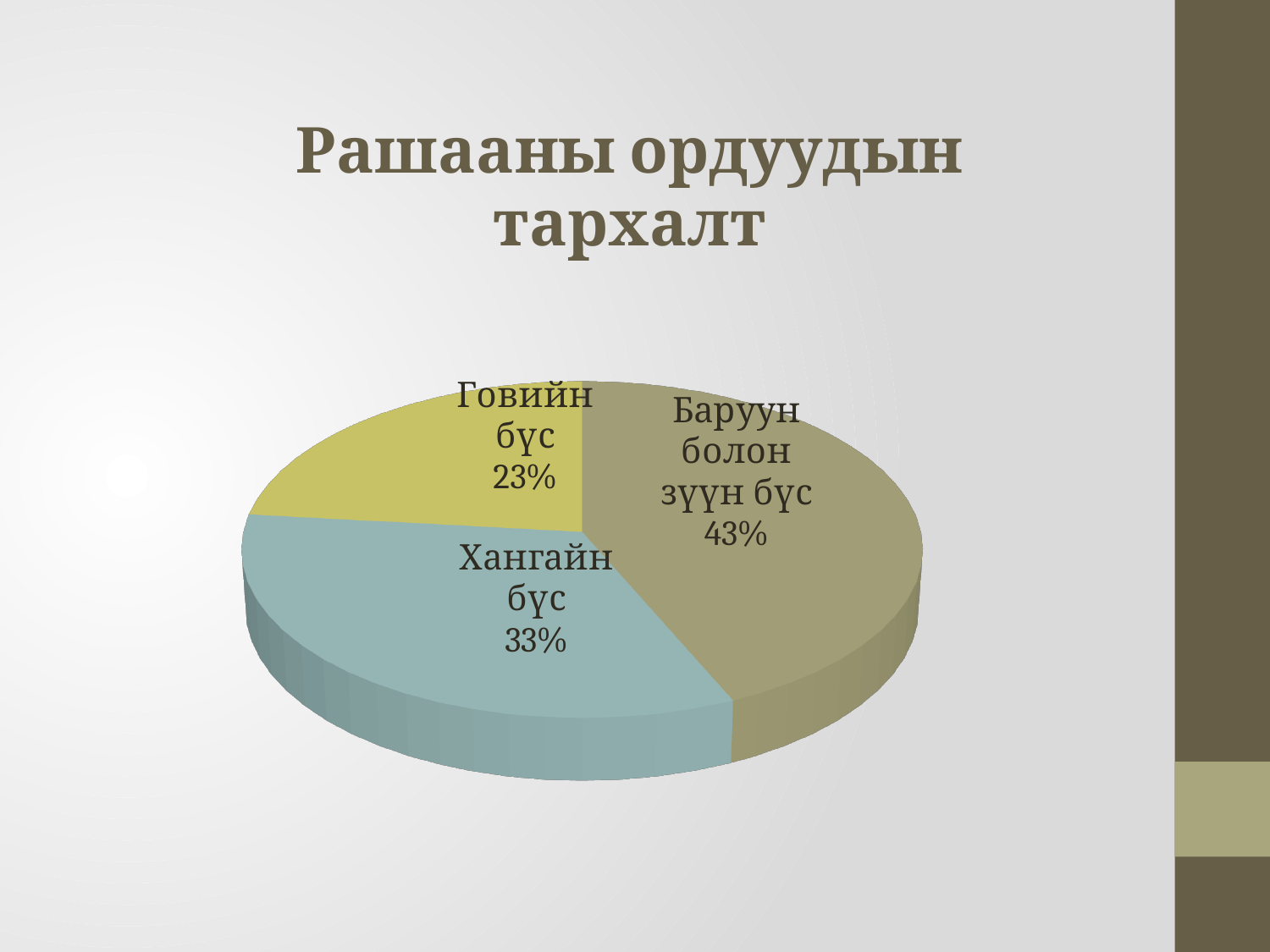
What share of the pie does Говийн бүс have? 23% What is the difference in percentage points between Хангайн бүс and Говийн бүс? 10 What colour is the slice for Говийн бүс? Yellow What kind of chart is shown on the slide? Pie chart What share of the pie does Хангайн бүс have? 33% Which region has the smallest slice of the pie? Говийн бүс What is the title of the chart on the slide? Рашааны ордуудын тархалт Which region has the largest slice of the pie? Баруун болон зүүн бүс How many slices does the pie chart have? 3 What share of the pie does Баруун болон зүүн бүс have? 43% What is the difference in percentage points between Баруун болон зүүн бүс and Говийн бүс? 20 Which is larger, the share for Хангайн бүс or the share for Говийн бүс? Хангайн бүс